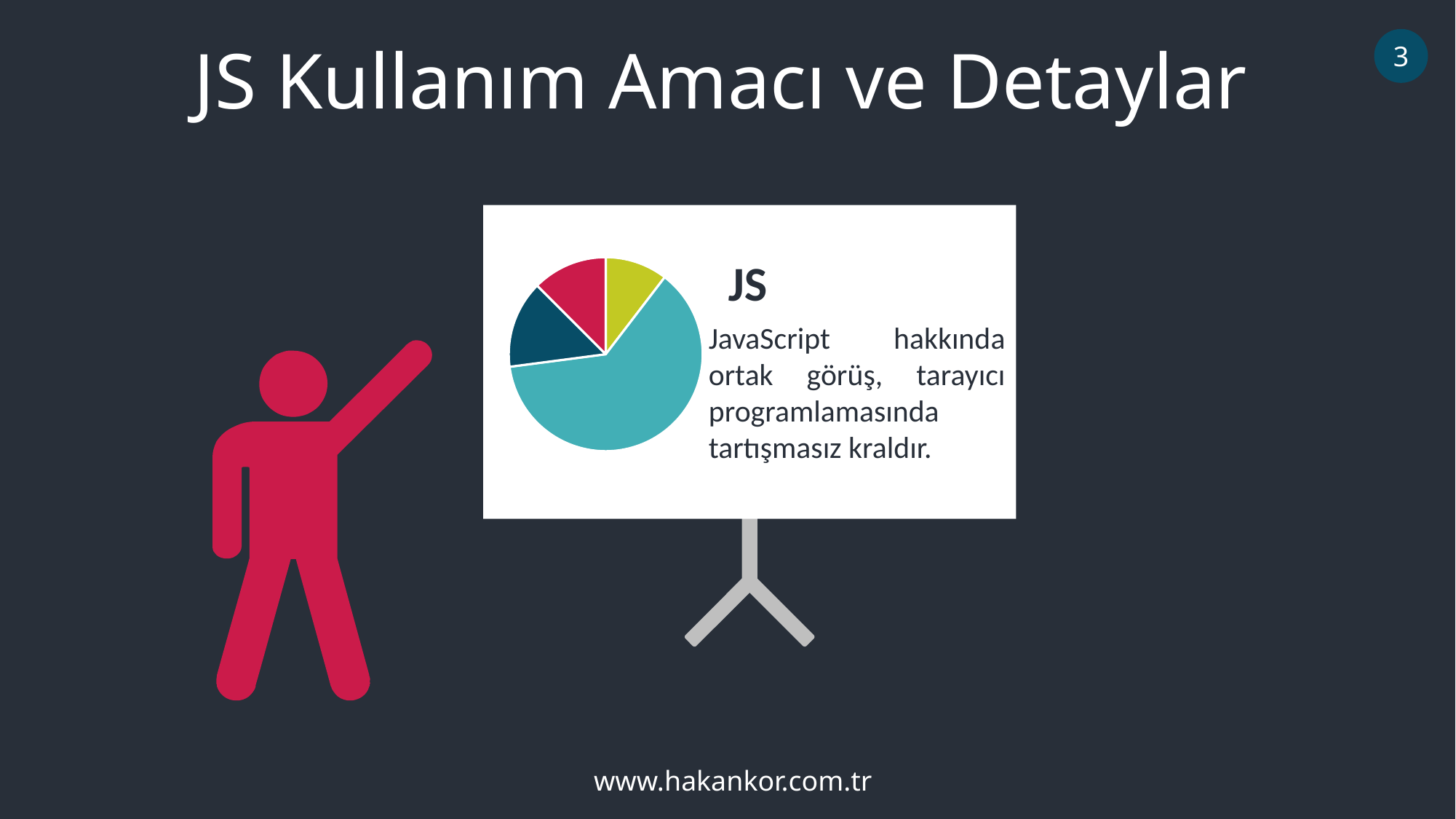
Which colour slice is the largest in the pie chart? teal Does the teal slice cover more or less than half of the pie chart? more Does the pie chart display a legend? No What kind of chart is shown on the whiteboard in the slide? pie chart Which is larger in the pie chart, the teal slice or the red slice? the teal slice How many slices does the pie chart have? 4 What heading appears next to the pie chart on the whiteboard? JS Which is larger in the pie chart, the teal slice or the dark blue slice? the teal slice